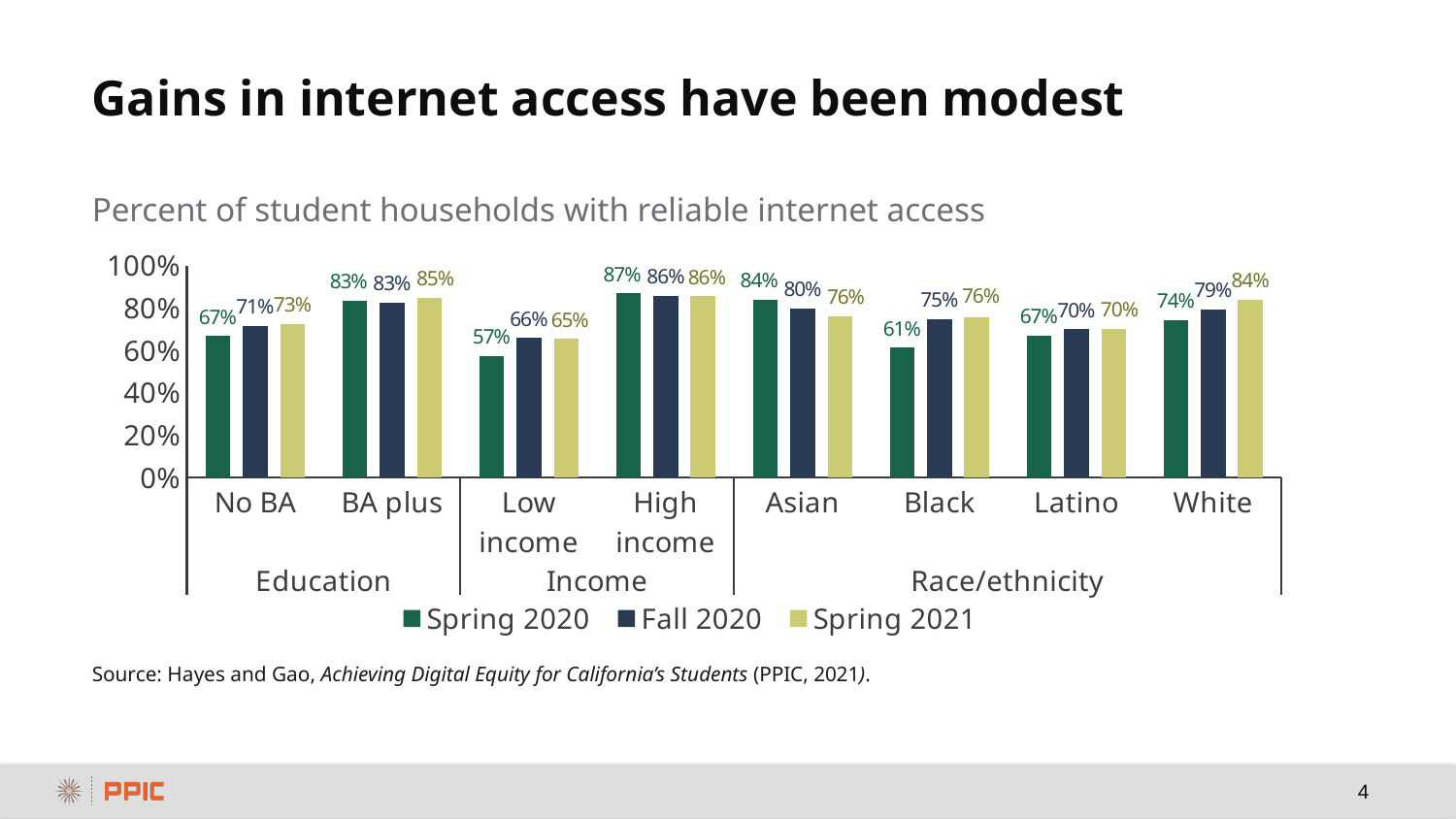
Which category has the lowest Spring 2020 value? Low income Which is larger, the Fall 2020 value for Asian or the Fall 2020 value for Latino? Asian What is the title of the chart? Percent of student households with reliable internet access What is the Spring 2020 value for High income? 87% How many categories are shown on the x axis? 8 Do the values for Asian rise or fall from Spring 2020 to Spring 2021? Fall What kind of chart is shown on the slide? Bar chart What is the Spring 2021 value for Low income? 65% What is the difference between the Spring 2021 and Spring 2020 values for White? 10% What is the Fall 2020 value for Black? 75% How many series does the legend list? 3 Which category has the highest Spring 2021 value? High income